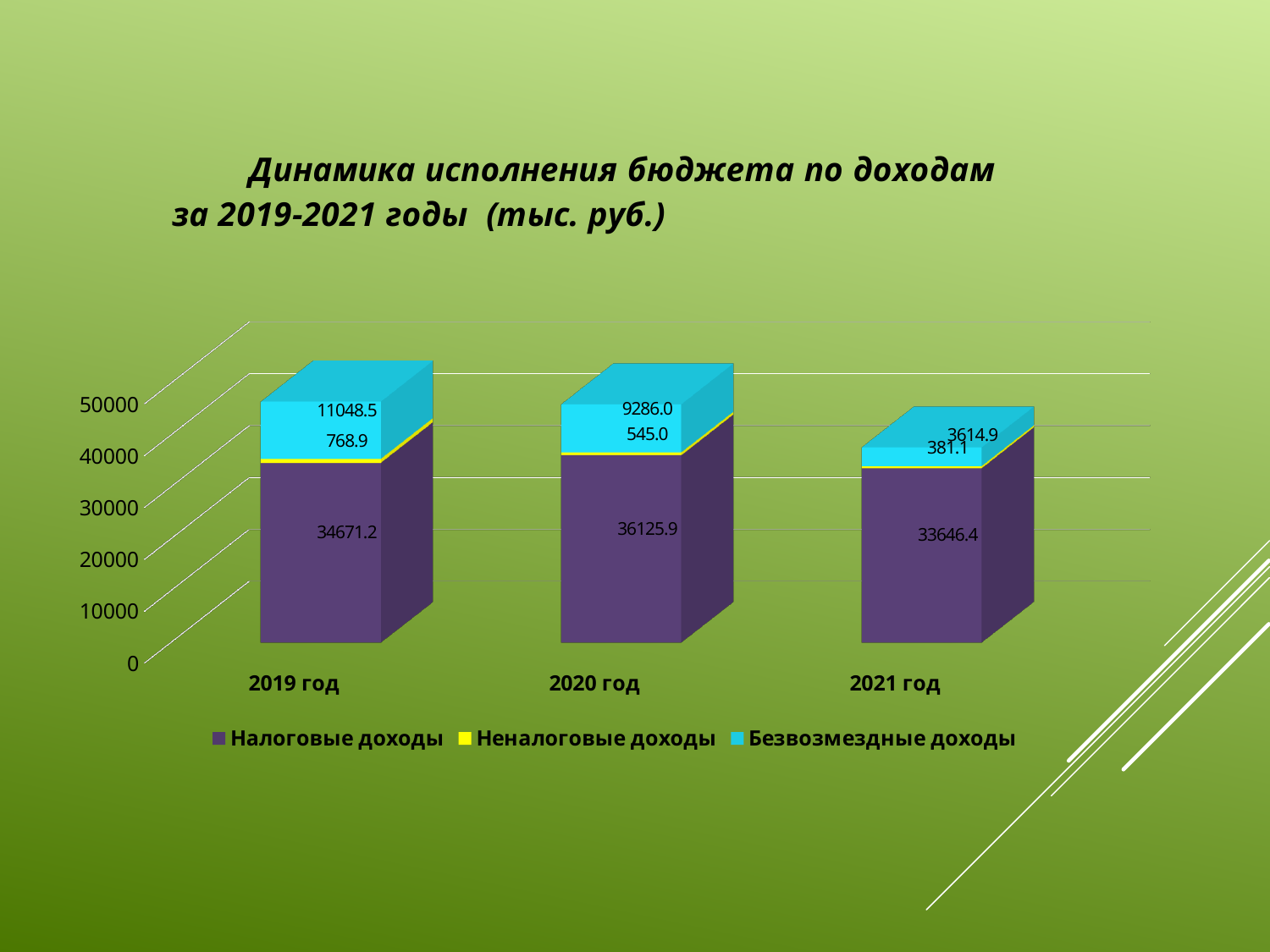
What is the difference between Налоговые доходы in 2020 год and 2019 год? 1454.7 How many series does the legend list? 3 What type of chart is shown on the slide? Stacked bar chart Which is larger: Безвозмездные доходы in 2019 год or in 2020 год? 2019 год In which year is Безвозмездные доходы the lowest? 2021 год In which year is Налоговые доходы the highest? 2020 год What is the value of Неналоговые доходы for 2021 год? 381.1 How many years (categories) are shown on the x axis? 3 What is the value of Безвозмездные доходы for 2019 год? 11048.5 What is the value of Налоговые доходы for 2020 год? 36125.9 What is the total of the stacked bar for 2021 год? 37642.4 Do the values of Неналоговые доходы rise or fall from 2019 год to 2021 год? Fall